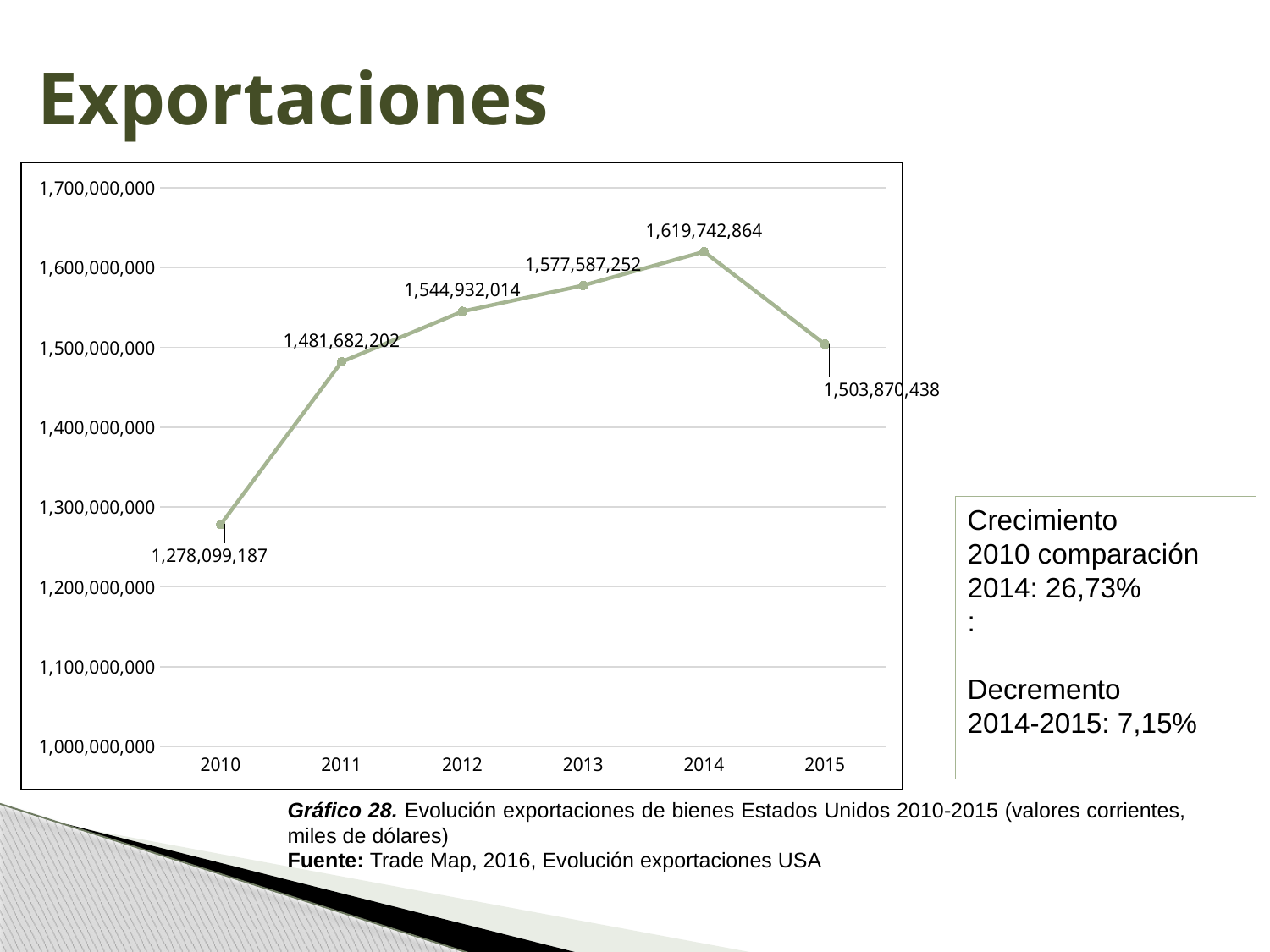
What is the value plotted for 2012? 1,544,932,014 What is the value plotted for 2010? 1,278,099,187 What is the value plotted for 2015? 1,503,870,438 How many years are plotted on the chart? 6 Which year has the highest value? 2014 Which year has the lowest value? 2010 What is the difference between the values for 2014 and 2015? 115,872,426 What is the value plotted for 2014? 1,619,742,864 Which is larger, the value for 2013 or the value for 2015? 2013 What kind of chart is shown on the slide? line chart Is the value for 2012 greater or less than 1,500,000,000? greater What is the difference between the values for 2011 and 2010? 203,583,015